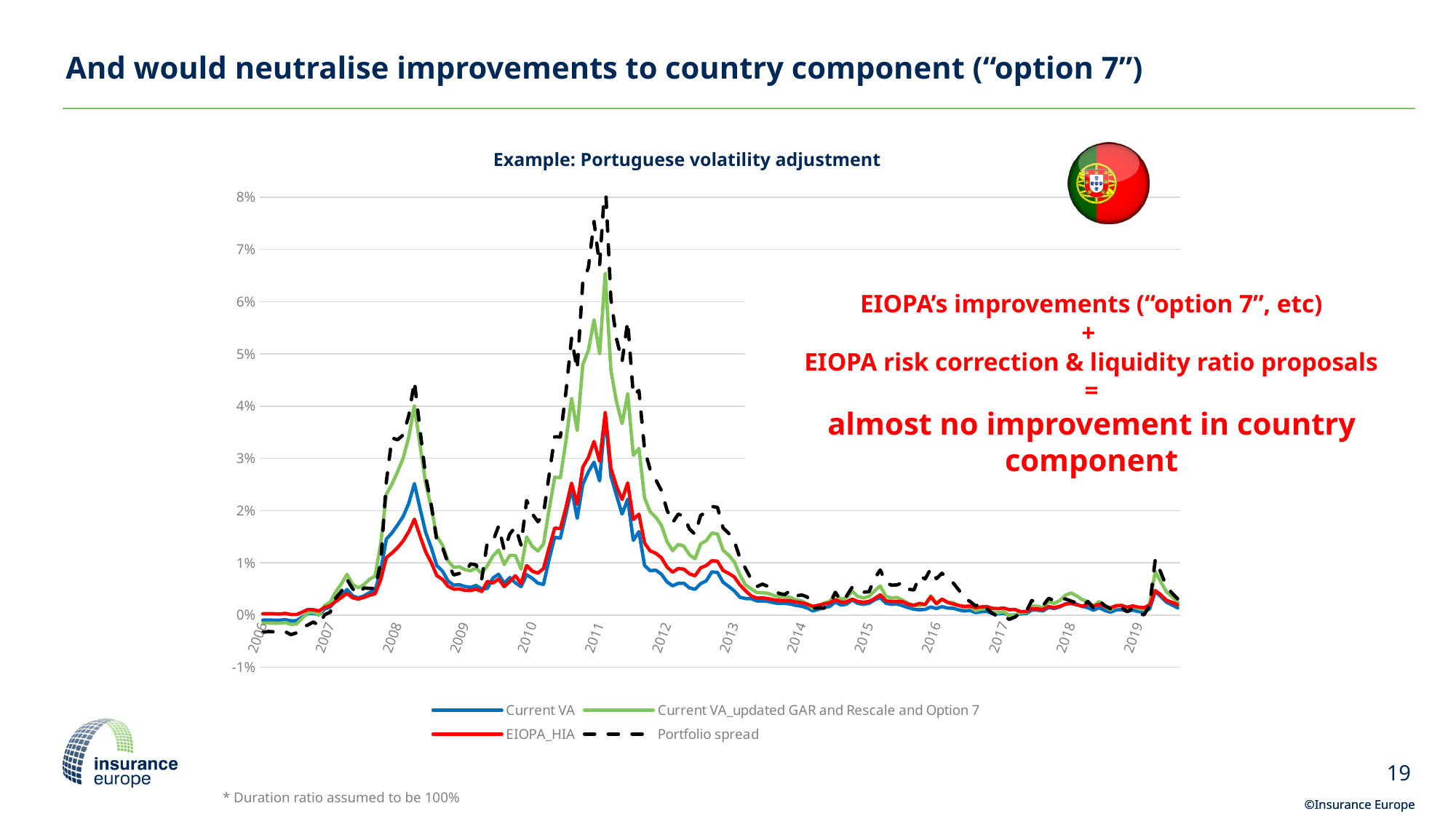
Around 2011, which series is higher: Current VA or Current VA_updated GAR and Rescale and Option 7? Current VA_updated GAR and Rescale and Option 7 Which series reaches the highest peak on the chart? Portfolio spread Is the peak value of the Portfolio spread series around 2011 greater or less than 7%? greater Which series is drawn as a dashed black line? Portfolio spread What kind of chart is shown on the slide? Line chart Around 2008, which series is higher: EIOPA_HIA or Portfolio spread? Portfolio spread Is the peak value of the Current VA_updated GAR and Rescale and Option 7 series around 2011 greater or less than 6%? greater Do the values of the Current VA series rise or fall between 2011 and 2014? fall How many series does the chart legend list? 4 How many year labels are shown on the x axis? 14 Is the peak value of the Current VA series around 2011 greater or less than 4%? less What is the title of the chart? Example: Portuguese volatility adjustment